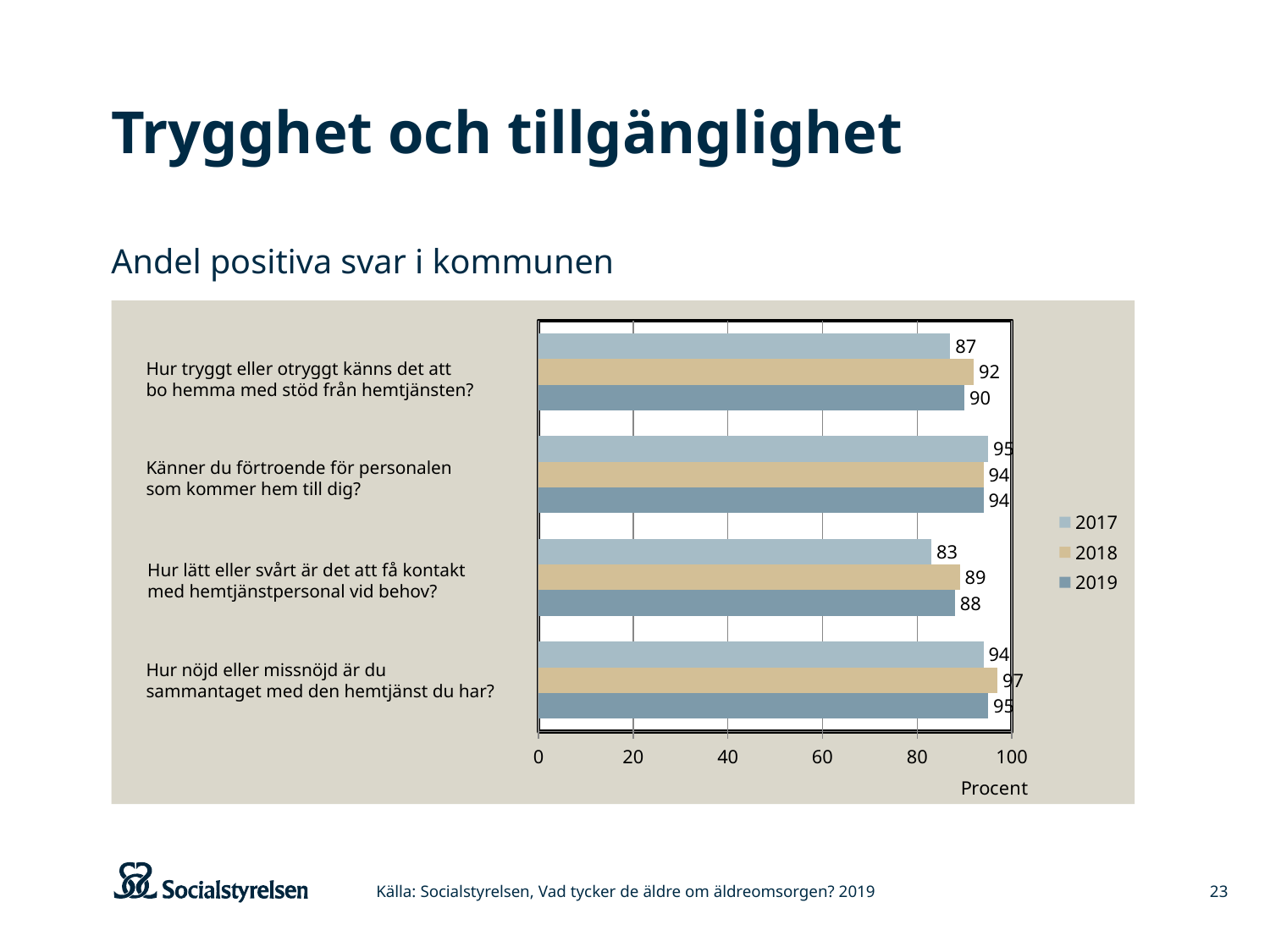
What is the 2019 value for "Hur tryggt eller otryggt känns det att bo hemma med stöd från hemtjänsten?"? 90 What is the difference between the 2018 and 2017 values for "Hur lätt eller svårt är det att få kontakt med hemtjänstpersonal vid behov?"? 6 What is the label on the horizontal axis of the chart? Procent Is the 2017 value for "Känner du förtroende för personalen som kommer hem till dig?" greater or less than 80? greater For "Hur tryggt eller otryggt känns det att bo hemma med stöd från hemtjänsten?", which year has the larger value, 2017 or 2018? 2018 Which question category has the highest 2018 value? Hur nöjd eller missnöjd är du sammantaget med den hemtjänst du har? What is the 2018 value for "Hur nöjd eller missnöjd är du sammantaget med den hemtjänst du har?"? 97 What is the 2017 value for "Hur lätt eller svårt är det att få kontakt med hemtjänstpersonal vid behov?"? 83 How many question categories are shown on the chart? 4 How many series does the legend list? 3 What type of chart is shown on the slide? Bar chart Which question category has the lowest 2017 value? Hur lätt eller svårt är det att få kontakt med hemtjänstpersonal vid behov?